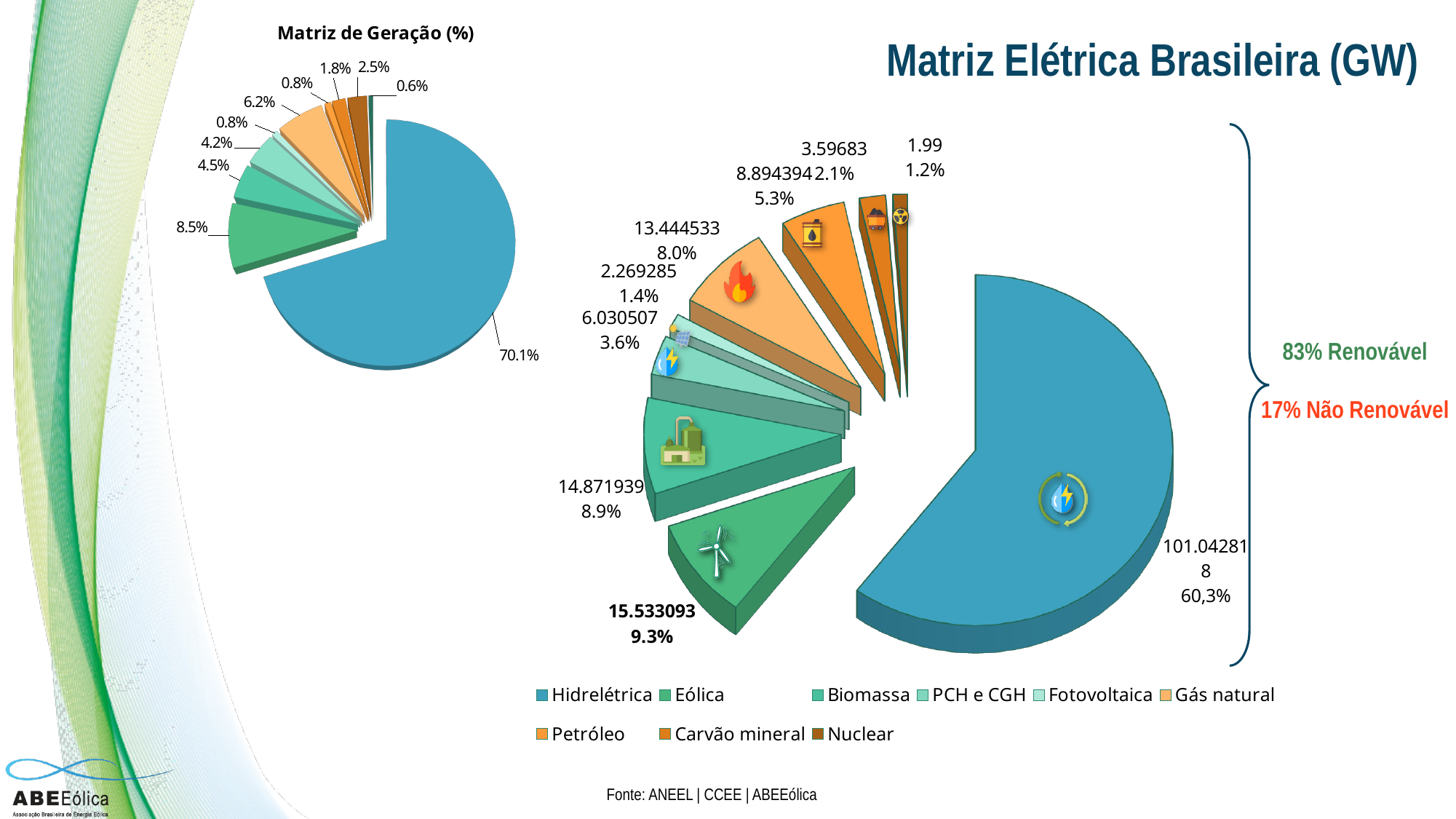
In the large pie chart 'Matriz Elétrica Brasileira (GW)', what value in GW is shown for Gás natural? 13.444533 In the large pie chart 'Matriz Elétrica Brasileira (GW)', what percentage is shown for Biomassa? 8.9% In the large pie chart 'Matriz Elétrica Brasileira (GW)', what is the difference in percentage points between Eólica (9.3%) and Biomassa (8.9%)? 0.4 In the large pie chart 'Matriz Elétrica Brasileira (GW)', what percentage is shown for Hidrelétrica? 60,3% In the large pie chart 'Matriz Elétrica Brasileira (GW)', what value in GW is shown for Eólica? 15.533093 How many entries does the legend of the large pie chart 'Matriz Elétrica Brasileira (GW)' list? 9 In the large pie chart 'Matriz Elétrica Brasileira (GW)', which is larger, Petróleo or Carvão mineral? Petróleo What type of chart is 'Matriz Elétrica Brasileira (GW)'? Pie chart In the small pie chart 'Matriz de Geração (%)' at the top left, what percentage is shown for the largest slice? 70.1% How many slices does the small pie chart 'Matriz de Geração (%)' at the top left have? 10 In the large pie chart 'Matriz Elétrica Brasileira (GW)', which category has the largest slice? Hidrelétrica In the large pie chart 'Matriz Elétrica Brasileira (GW)', which category has the smallest slice? Nuclear